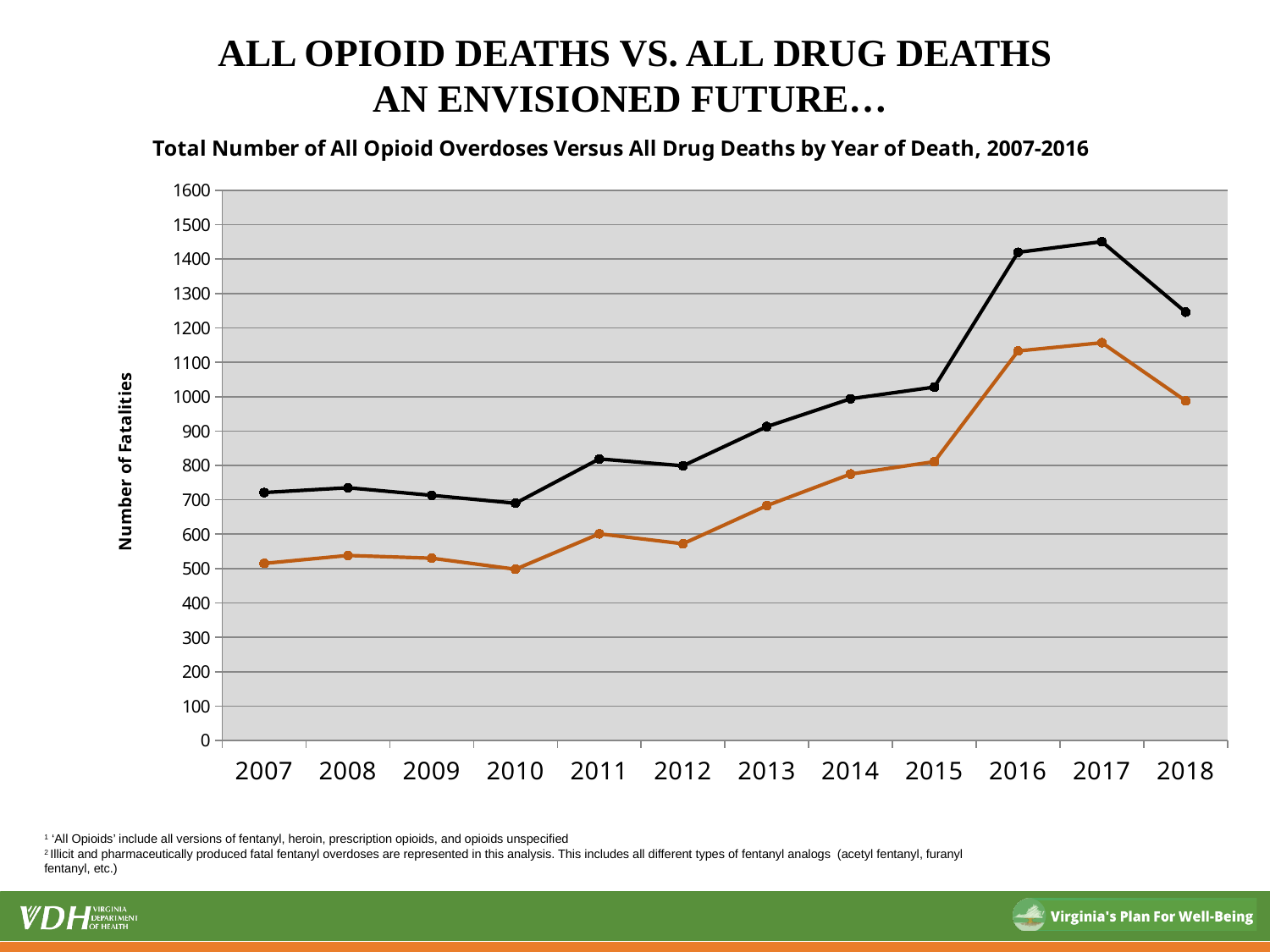
How many lines are plotted on the chart? 2 Is the value of the orange line in 2014 greater or less than 700? greater Do the values of both lines rise or fall from 2017 to 2018? fall In 2016, which line has the higher value, the black line or the orange line? the black line How many years are shown along the x axis of the chart? 12 Is the value of the orange line in 2016 greater or less than 1100? greater What kind of chart is shown on the slide? line chart What is the label of the vertical axis? Number of Fatalities What is the title printed above the chart? Total Number of All Opioid Overdoses Versus All Drug Deaths by Year of Death, 2007-2016 Is the value of the black line in 2018 greater or less than 1200? greater